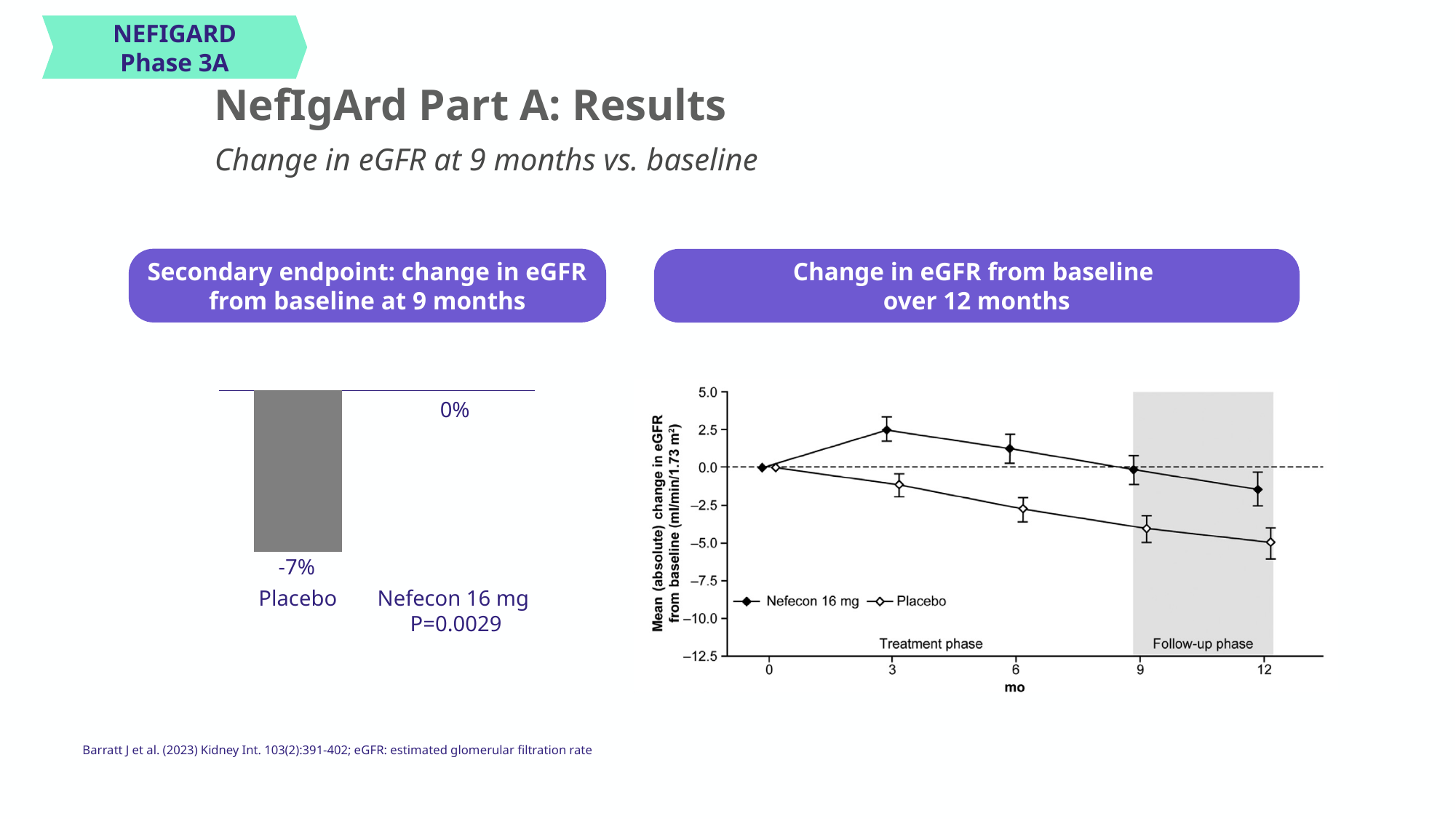
In the right chart (Change in eGFR from baseline over 12 months), which series is higher at 6 months, Nefecon 16 mg or Placebo? Nefecon 16 mg How many series does the legend of the right chart (Change in eGFR from baseline over 12 months) list? 2 In the left chart (Secondary endpoint: change in eGFR from baseline at 9 months), what is the value for Placebo? -7% What kind of chart is the right chart (Change in eGFR from baseline over 12 months)? Line chart In the right chart (Change in eGFR from baseline over 12 months), does the Placebo series rise or fall from 0 to 12 months? Fall In the right chart (Change in eGFR from baseline over 12 months), how many time points are plotted on the x axis? 5 In the left chart (Secondary endpoint: change in eGFR from baseline at 9 months), which group has the lower value? Placebo In the left chart (Secondary endpoint: change in eGFR from baseline at 9 months), what is the value for Nefecon 16 mg? 0% What kind of chart is the left chart (Secondary endpoint: change in eGFR from baseline at 9 months)? Bar chart In the right chart (Change in eGFR from baseline over 12 months), is the Placebo value at 12 months greater or less than -2.5? less In the left chart (Secondary endpoint: change in eGFR from baseline at 9 months), what is the difference between the Nefecon 16 mg value and the Placebo value? 7% In the left chart (Secondary endpoint: change in eGFR from baseline at 9 months), what P value is shown? P=0.0029